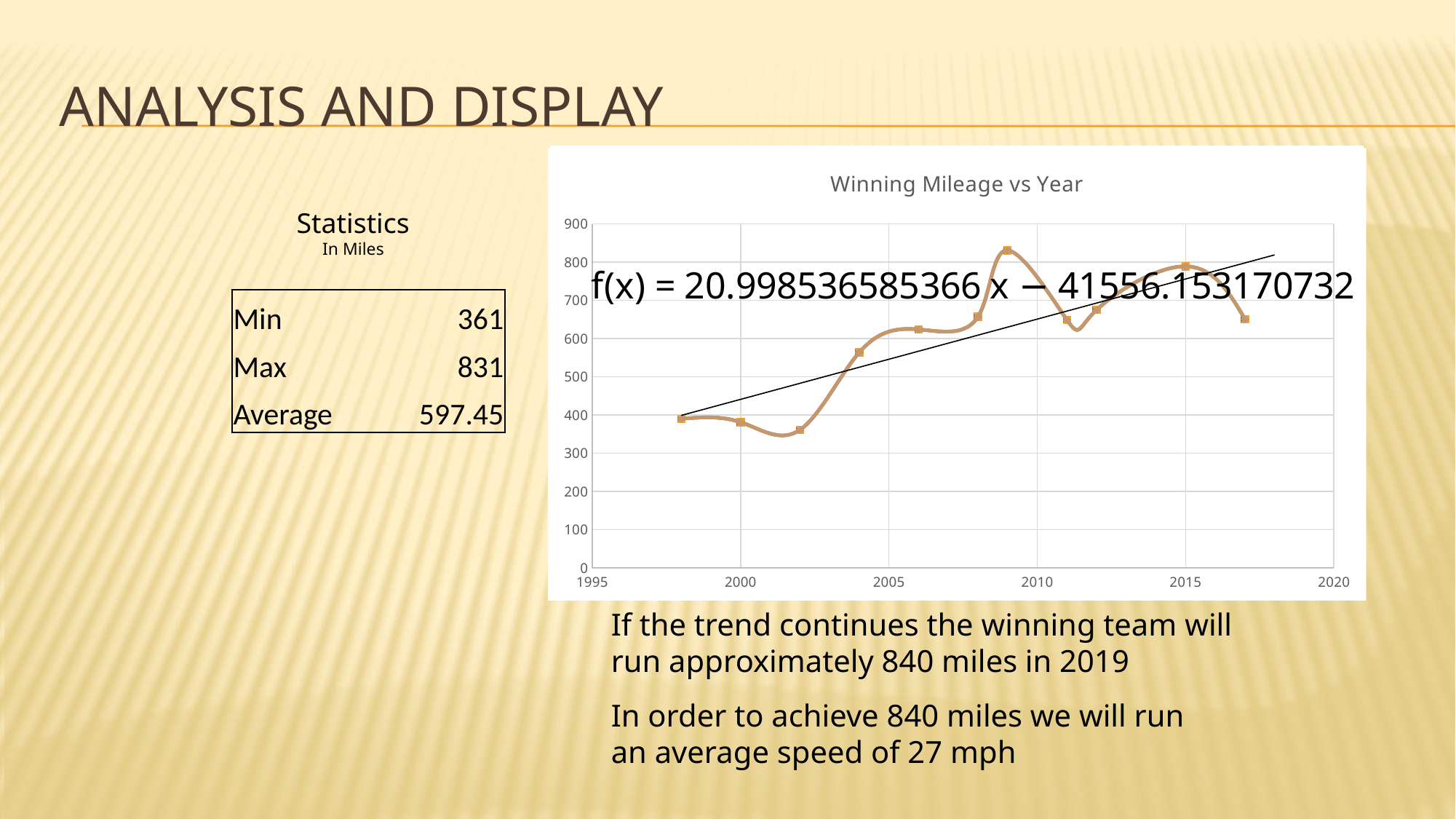
Is the value for 2004 greater or less than 500? greater Is the value for 2009 greater or less than 800? greater Is the value for 2002 greater or less than 400? less What is the trendline equation displayed on the chart? f(x) = 20.998536585366 x − 41556.153170732 What is the title of the chart? Winning Mileage vs Year In which year does the chart show the lowest winning mileage? 2002 Which year has the larger winning mileage, 2009 or 2017? 2009 What kind of chart is shown on the slide? line chart In which year does the chart show the highest winning mileage? 2009 How many data points are plotted on the chart? 11 Overall, do the winning mileage values rise or fall from 1998 to 2017? rise